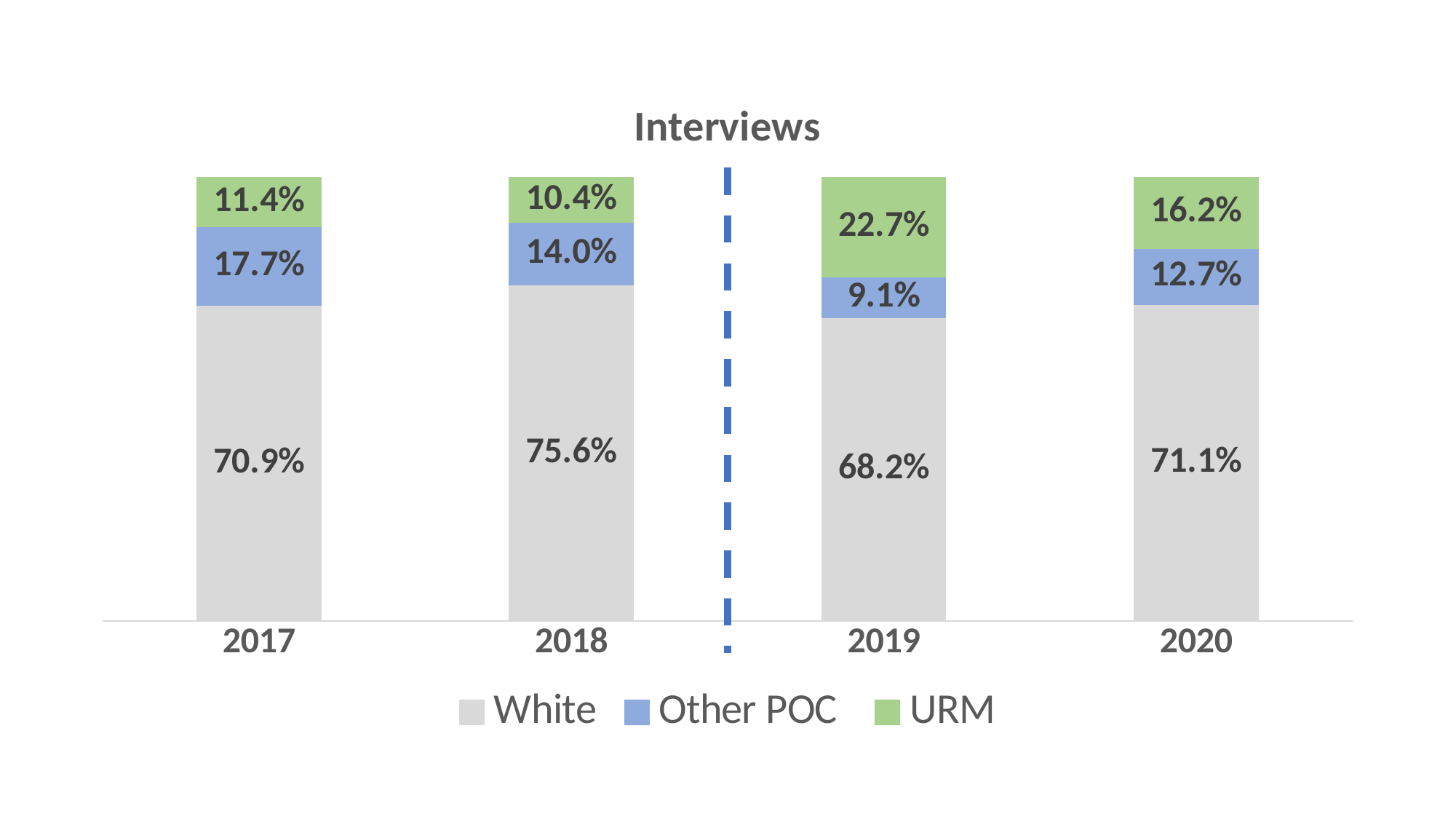
What is the URM share of interviews in 2019? 22.7% What is the White share of interviews in 2018? 75.6% What is the Other POC share of interviews in 2020? 12.7% Which is larger: the Other POC share in 2017 or the Other POC share in 2018? 2017 What is the title of the chart? Interviews How many years are shown on the x axis of the Interviews chart? 4 Which colour represents URM in the chart? Green In which year is the Other POC share of interviews lowest? 2019 What is the difference between the URM share in 2019 and the URM share in 2018? 12.3% What kind of chart is shown on the slide? Stacked bar chart In which year is the URM share of interviews highest? 2019 How many series does the legend list? 3